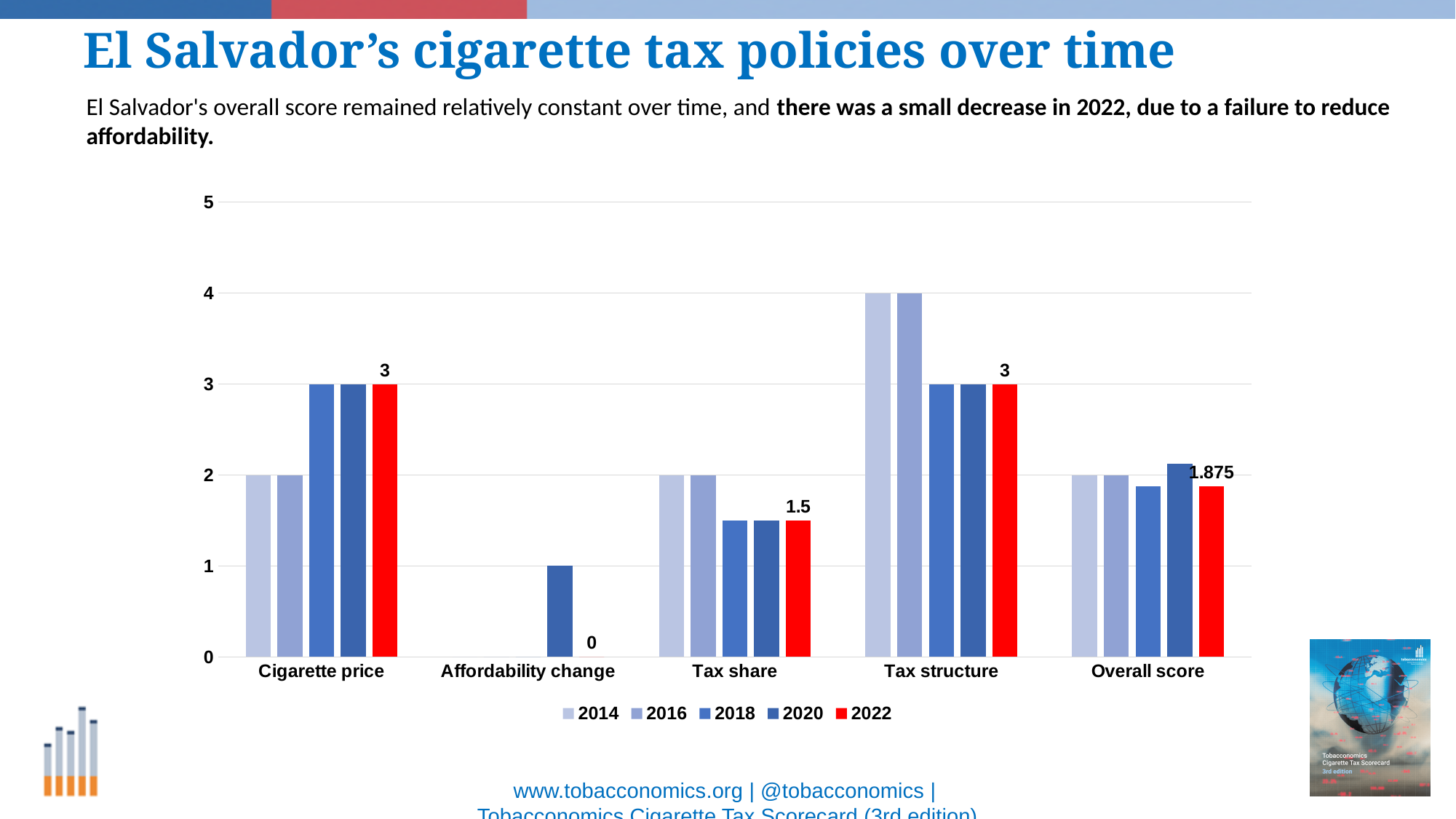
What is the value for Cigarette price in 2022? 3 What is the value for Affordability change in 2022? 0 What is the value for Tax structure in 2014? 4 What is the value for Tax share in 2022? 1.5 Which category has the highest value in 2014? Tax structure Is the value for Overall score in 2020 greater or less than 2? greater Do the values for Tax structure rise or fall from 2014 to 2022? fall What is the difference between the 2022 values for Tax structure and Tax share? 1.5 What is the value for Overall score in 2022? 1.875 Which category has the lowest value in 2022? Affordability change Which is larger in 2022: Overall score or Tax share? Overall score How many series does the legend list? 5